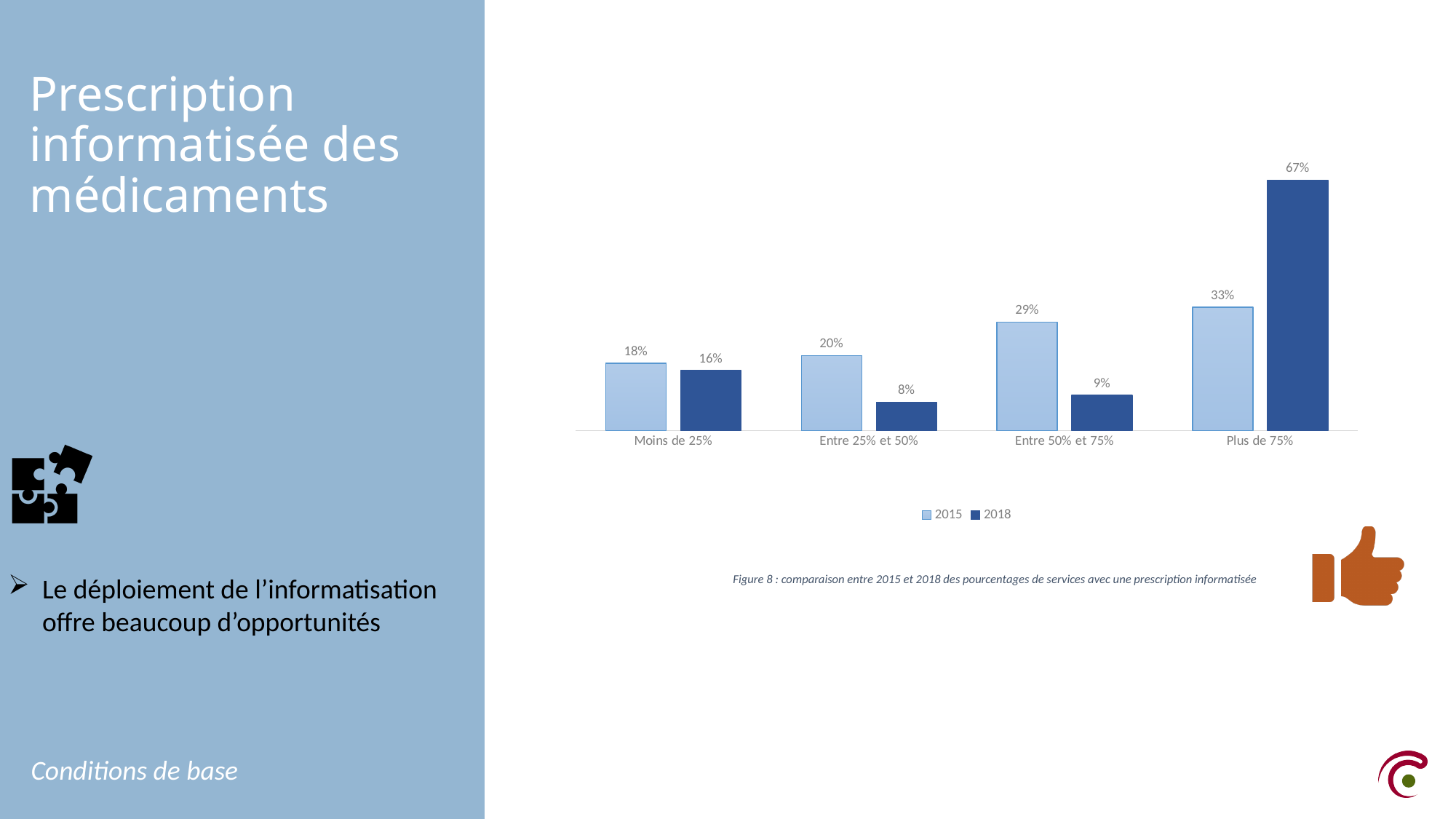
What is the 2018 value for the 'Entre 25% et 50%' category? 8% Which category has the highest 2018 value? Plus de 75% Which category has the lowest 2015 value? Moins de 25% What is the 2015 value for the 'Entre 50% et 75%' category? 29% What is the difference between the 2018 and 2015 values for 'Plus de 75%'? 34% How many series does the legend list? 2 What is the 2015 value for the 'Moins de 25%' category? 18% Which category has the lowest 2018 value? Entre 25% et 50% What is the 2018 value for the 'Plus de 75%' category? 67% What kind of chart is shown on the slide? Bar chart Which is larger for 'Entre 50% et 75%': the 2015 value or the 2018 value? 2015 How many categories are shown on the x axis? 4